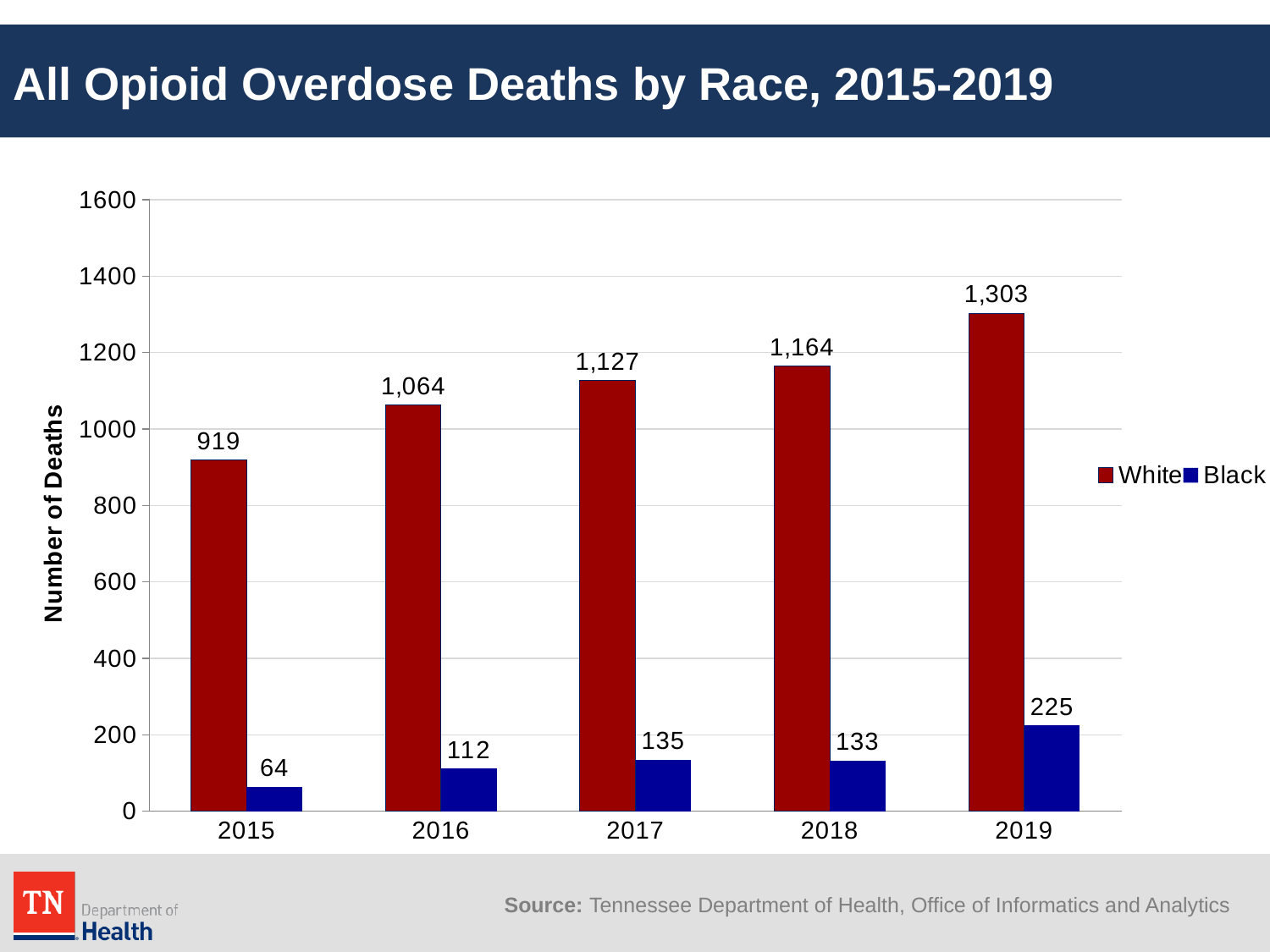
How many series does the legend list? 2 What kind of chart is shown on the slide? Bar chart In which year is the number of deaths for White lowest? 2015 Do the White values rise or fall from 2015 to 2019? Rise What is the number of opioid overdose deaths for Black in 2015? 64 How many years are shown on the x axis? 5 What is the value for White in 2017? 1,127 What is the difference between White and Black deaths in 2018? 1,031 Which is larger, the Black value in 2017 or the Black value in 2018? 2017 Is the value for White in 2016 greater or less than 1000? greater In which year is the number of deaths for Black highest? 2019 What is the number of opioid overdose deaths for White in 2019? 1,303